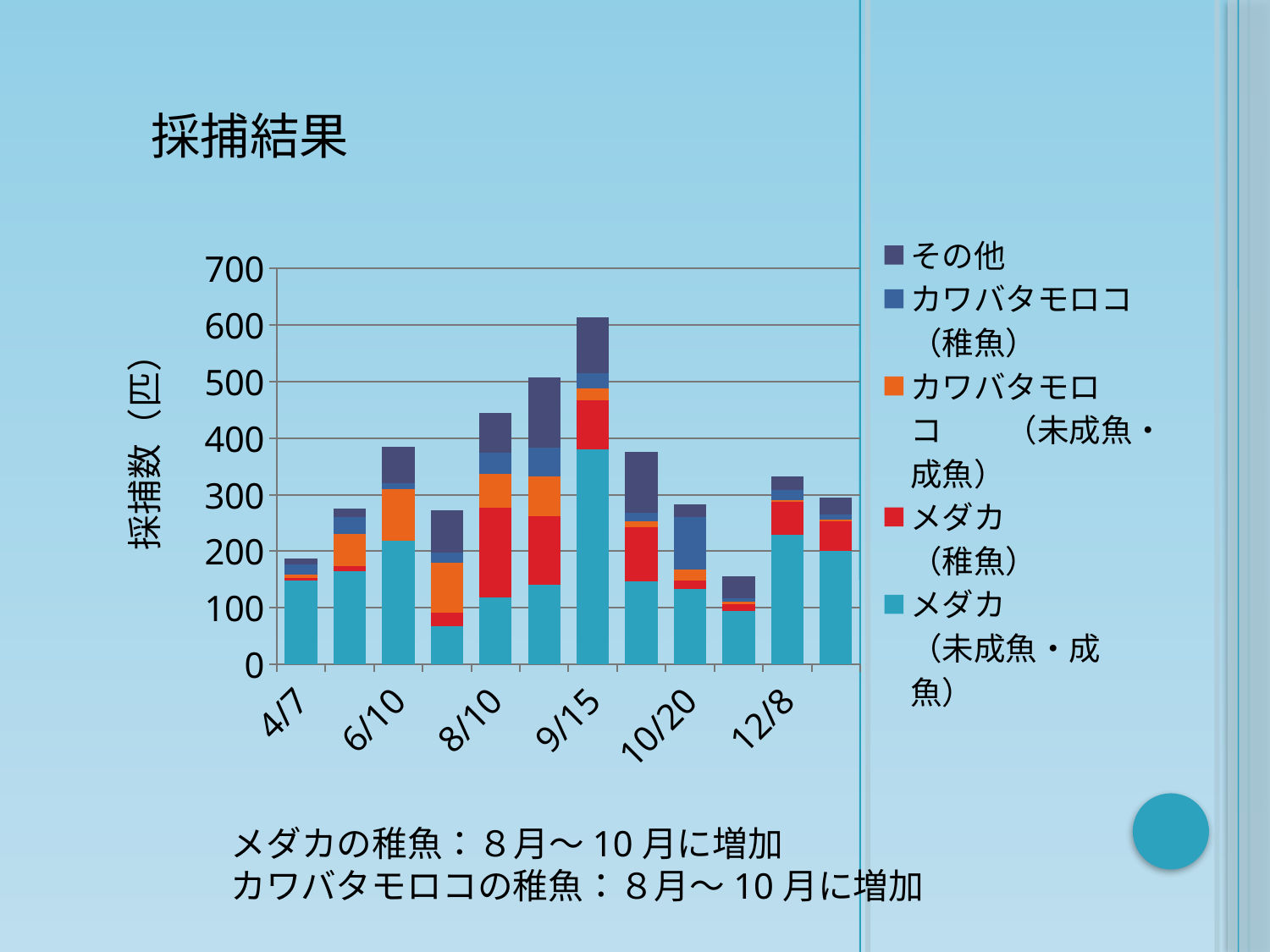
How many bars are plotted in the chart? 12 Which labeled date has the tallest stacked bar? 9/15 What is the y-axis title of the chart? 採捕数（匹） Which series is listed first (at the top) in the legend? その他 Is the total for 4/7 greater or less than 200? less Which has the larger total, 9/15 or 8/10? 9/15 How many series does the legend list? 5 Which has the larger total, 6/10 or 4/7? 6/10 What kind of chart is shown on the slide? stacked bar chart Is the total for 9/15 greater or less than 500? greater Is the メダカ（未成魚・成魚） value for 9/15 greater or less than 300? greater